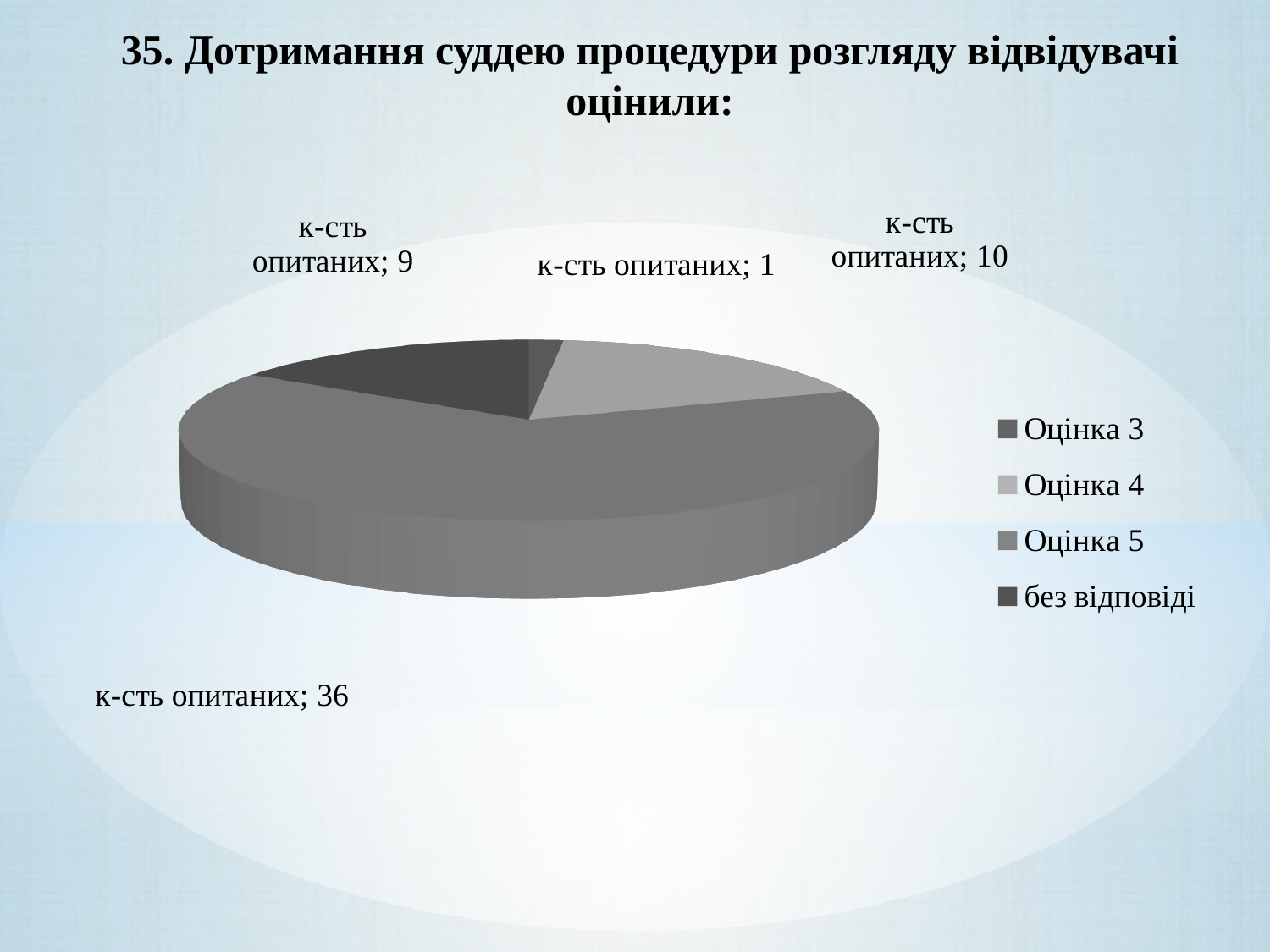
How many slices does the pie chart have? 4 Which has more respondents, Оцінка 4 or без відповіді? Оцінка 4 What kind of chart is shown on the slide? pie chart What is the number of respondents (к-сть опитаних) for без відповіді? 9 Which category has the largest slice of the pie chart? Оцінка 5 What is the total number of respondents across all slices of the pie chart? 56 What is the difference between the number of respondents for Оцінка 5 and for Оцінка 4? 26 What is the number of respondents (к-сть опитаних) for Оцінка 5? 36 What is the number of respondents (к-сть опитаних) for Оцінка 3? 1 What is the number of respondents (к-сть опитаних) for Оцінка 4? 10 How many categories does the legend of the pie chart list? 4 Which category has the smallest slice of the pie chart? Оцінка 3